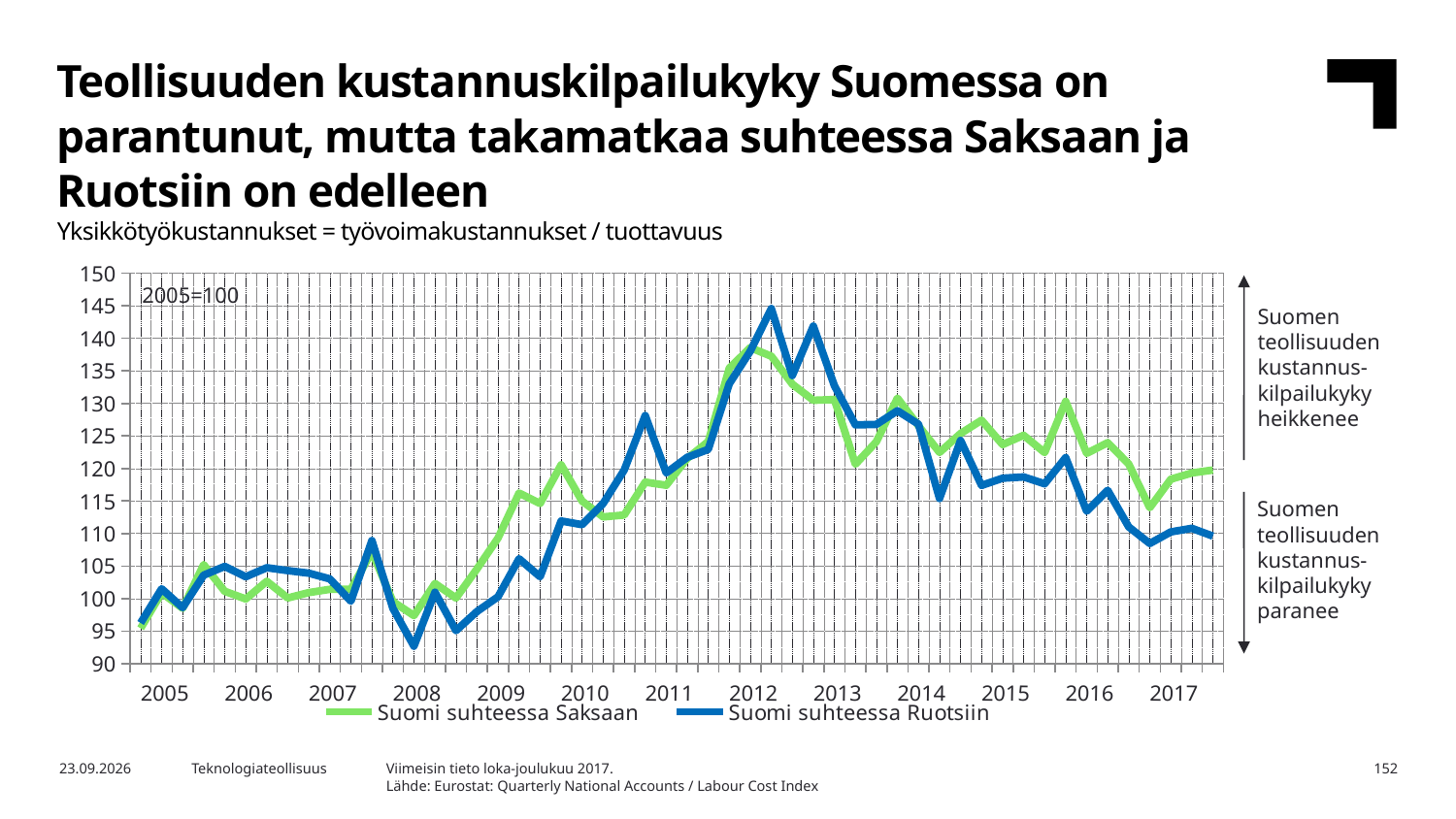
What are the two series named in the legend? Suomi suhteessa Saksaan; Suomi suhteessa Ruotsiin What base year and value is the index set to, according to the note in the chart? 2005=100 At the end of 2017, which series has the higher value: Suomi suhteessa Saksaan or Suomi suhteessa Ruotsiin? Suomi suhteessa Saksaan What kind of chart is shown on the slide? line chart Is the lowest value of the Suomi suhteessa Ruotsiin series in 2008 greater or less than 95? less How many years are labelled on the x axis? 13 How many series does the legend list? 2 Is the value of the Suomi suhteessa Ruotsiin series at the end of 2017 greater or less than 115? less Is the peak value of the Suomi suhteessa Ruotsiin series in 2012 greater or less than 140? greater At the 2012 peak, which series reaches the higher value: Suomi suhteessa Saksaan or Suomi suhteessa Ruotsiin? Suomi suhteessa Ruotsiin Do the values of the Suomi suhteessa Ruotsiin series generally rise or fall between 2012 and 2017? fall